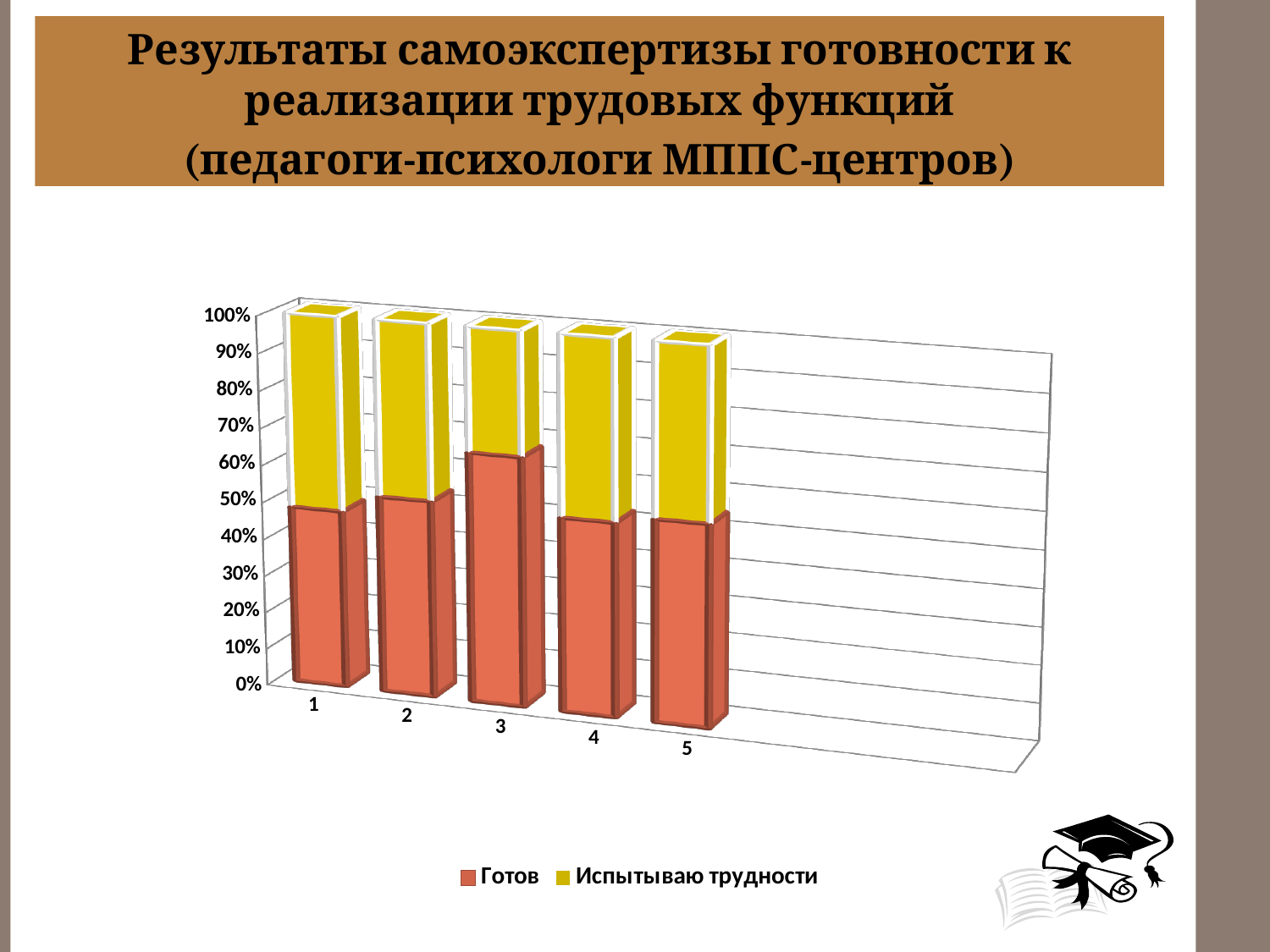
How many categories are shown on the x axis of the chart? 5 Which series is shown in red in the chart? Готов Which is larger for the series "Готов": category 3 or category 5? category 3 What kind of chart is shown on the slide? bar chart What are the two entries listed in the chart legend? Готов, Испытываю трудности How many series does the chart legend list? 2 Which category has the highest value for the series "Готов"? 3 What is the total of the stacked bar for category 3? 100% Which category has the lowest value for the series "Испытываю трудности"? 3 Is the value for "Готов" in category 3 greater or less than 50%? greater